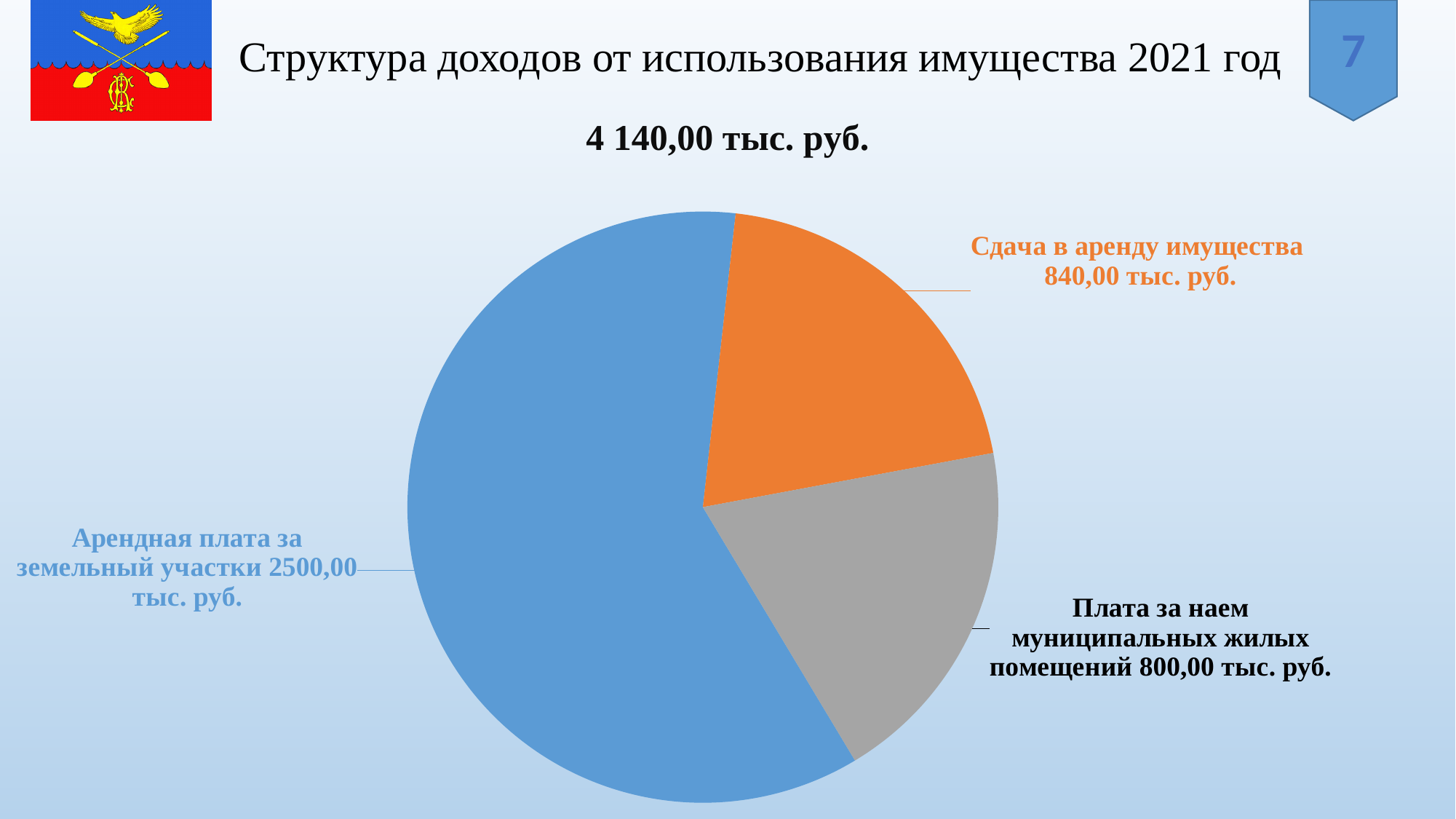
What total amount is shown above the pie chart? 4 140,00 тыс. руб. Which category has the largest share of the pie? Арендная плата за земельный участки What is the difference between «Сдача в аренду имущества» and «Плата за наем муниципальных жилых помещений»? 40,00 тыс. руб. What is the value for «Сдача в аренду имущества»? 840,00 тыс. руб. What colour is the slice for «Сдача в аренду имущества»? Orange Which category has the smallest share of the pie? Плата за наем муниципальных жилых помещений What is the value for «Плата за наем муниципальных жилых помещений»? 800,00 тыс. руб. Which is larger: «Сдача в аренду имущества» or «Плата за наем муниципальных жилых помещений»? Сдача в аренду имущества How many slices does the pie chart have? 3 What is the difference between «Арендная плата за земельный участки» and «Сдача в аренду имущества»? 1660,00 тыс. руб. What is the value for «Арендная плата за земельный участки»? 2500,00 тыс. руб. What kind of chart is shown on the slide? Pie chart